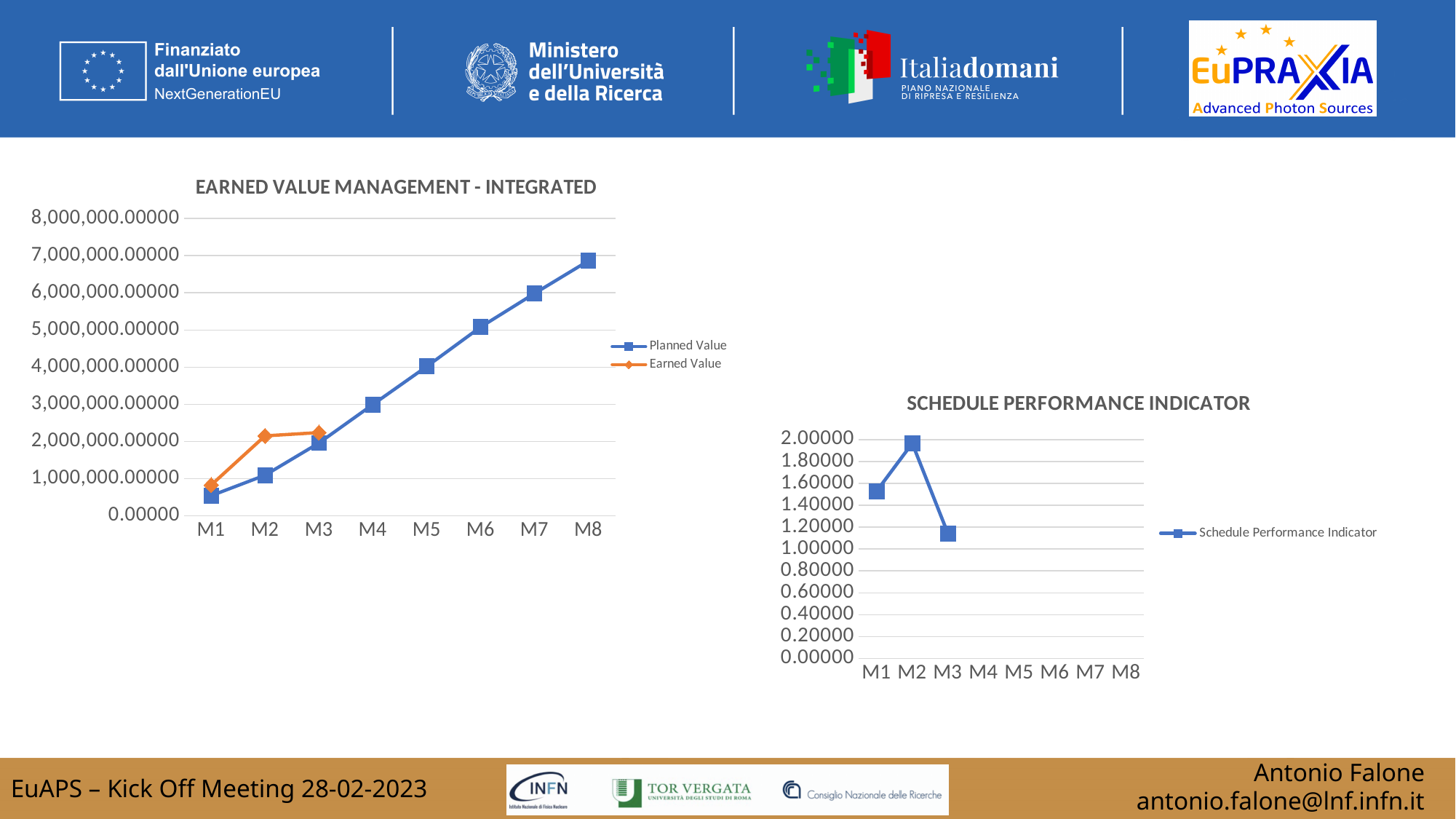
In the 'SCHEDULE PERFORMANCE INDICATOR' chart, how many series does the legend list? 1 In the 'EARNED VALUE MANAGEMENT - INTEGRATED' chart, is the Planned Value at M8 greater or less than 6,000,000.00000? greater In the 'EARNED VALUE MANAGEMENT - INTEGRATED' chart, does the Planned Value series rise or fall from M1 to M8? Rise In the 'EARNED VALUE MANAGEMENT - INTEGRATED' chart, how many series does the legend list? 2 In the 'EARNED VALUE MANAGEMENT - INTEGRATED' chart, how many categories are on the x axis? 8 In the 'EARNED VALUE MANAGEMENT - INTEGRATED' chart, at which month is the Planned Value highest? M8 In the 'SCHEDULE PERFORMANCE INDICATOR' chart, at which month is the Schedule Performance Indicator highest? M2 In the 'EARNED VALUE MANAGEMENT - INTEGRATED' chart, which is larger at M2: Planned Value or Earned Value? Earned Value In the 'EARNED VALUE MANAGEMENT - INTEGRATED' chart, which series is drawn in orange? Earned Value In the 'SCHEDULE PERFORMANCE INDICATOR' chart, is the value at M3 greater or less than 1.40000? less In the 'EARNED VALUE MANAGEMENT - INTEGRATED' chart, what kind of chart is shown? Line chart